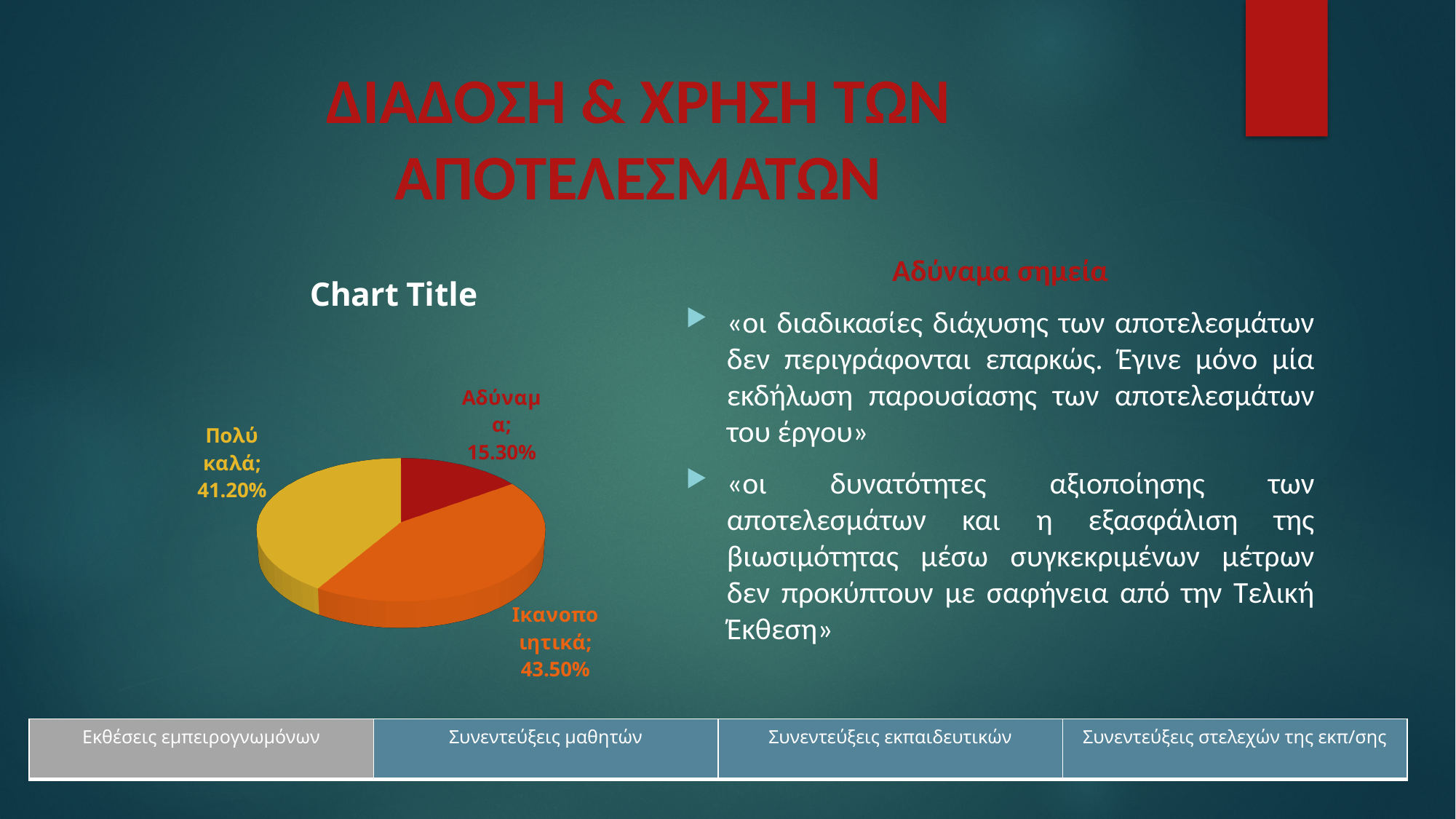
What is the value for Πολύ καλά in the pie chart? 41.20% What kind of chart is shown on the slide? pie chart Which category has the largest slice in the pie chart? Ικανοποιητικά Which category has the smallest slice in the pie chart? Αδύναμα What is the difference between the values for Ικανοποιητικά and Πολύ καλά? 2.30% What colour is the Αδύναμα slice in the pie chart? red What is the title of the pie chart? Chart Title How many slices does the pie chart have? 3 What is the difference between the values for Πολύ καλά and Αδύναμα? 25.90% Which is larger, the value for Πολύ καλά or the value for Αδύναμα? Πολύ καλά What is the value for Ικανοποιητικά in the pie chart? 43.50% What is the value for Αδύναμα in the pie chart? 15.30%